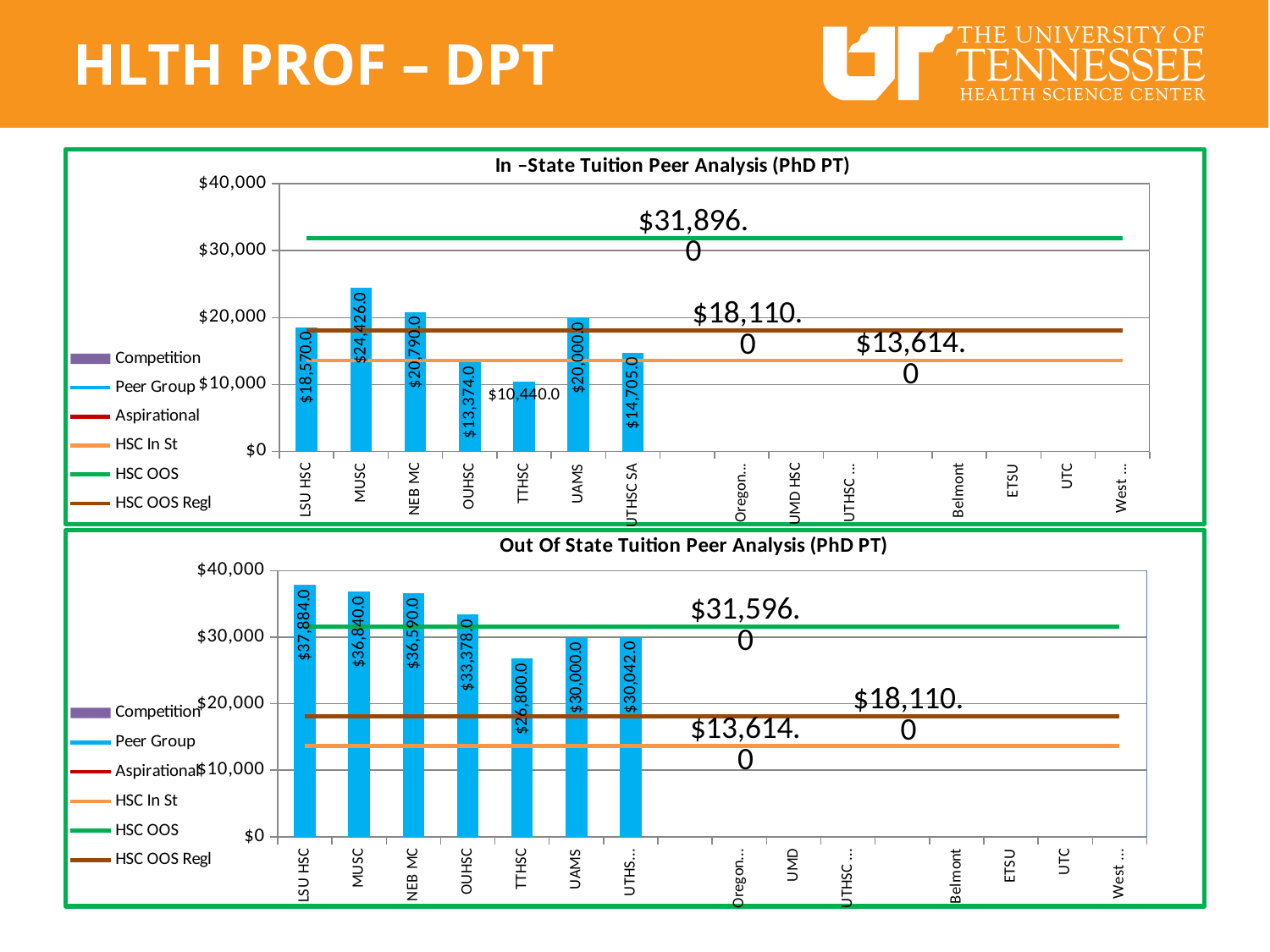
In the Out Of State Tuition Peer Analysis chart, what is the value for LSU HSC? $37,884.0 In the Out Of State Tuition Peer Analysis chart, what is the difference between the MUSC and NEB MC values? $250.0 In the In-State Tuition Peer Analysis chart, what value is labelled on the HSC OOS line? $31,896.0 How many series does the legend of the In-State Tuition Peer Analysis chart list? 6 In the In-State Tuition Peer Analysis chart, which institution has the highest bar? MUSC In the In-State Tuition Peer Analysis chart, which institution has the lowest bar? TTHSC In the Out Of State Tuition Peer Analysis chart, which institution has the lowest bar? TTHSC In the Out Of State Tuition Peer Analysis chart, is the value for TTHSC greater or less than $30,000? less What kind of chart is the Out Of State Tuition Peer Analysis chart? Bar chart In the In-State Tuition Peer Analysis chart, what is the difference between the NEB MC and UAMS values? $790.0 In the Out Of State Tuition Peer Analysis chart, which is larger, the value for OUHSC or the value for UAMS? OUHSC In the In-State Tuition Peer Analysis chart, what is the value for MUSC? $24,426.0